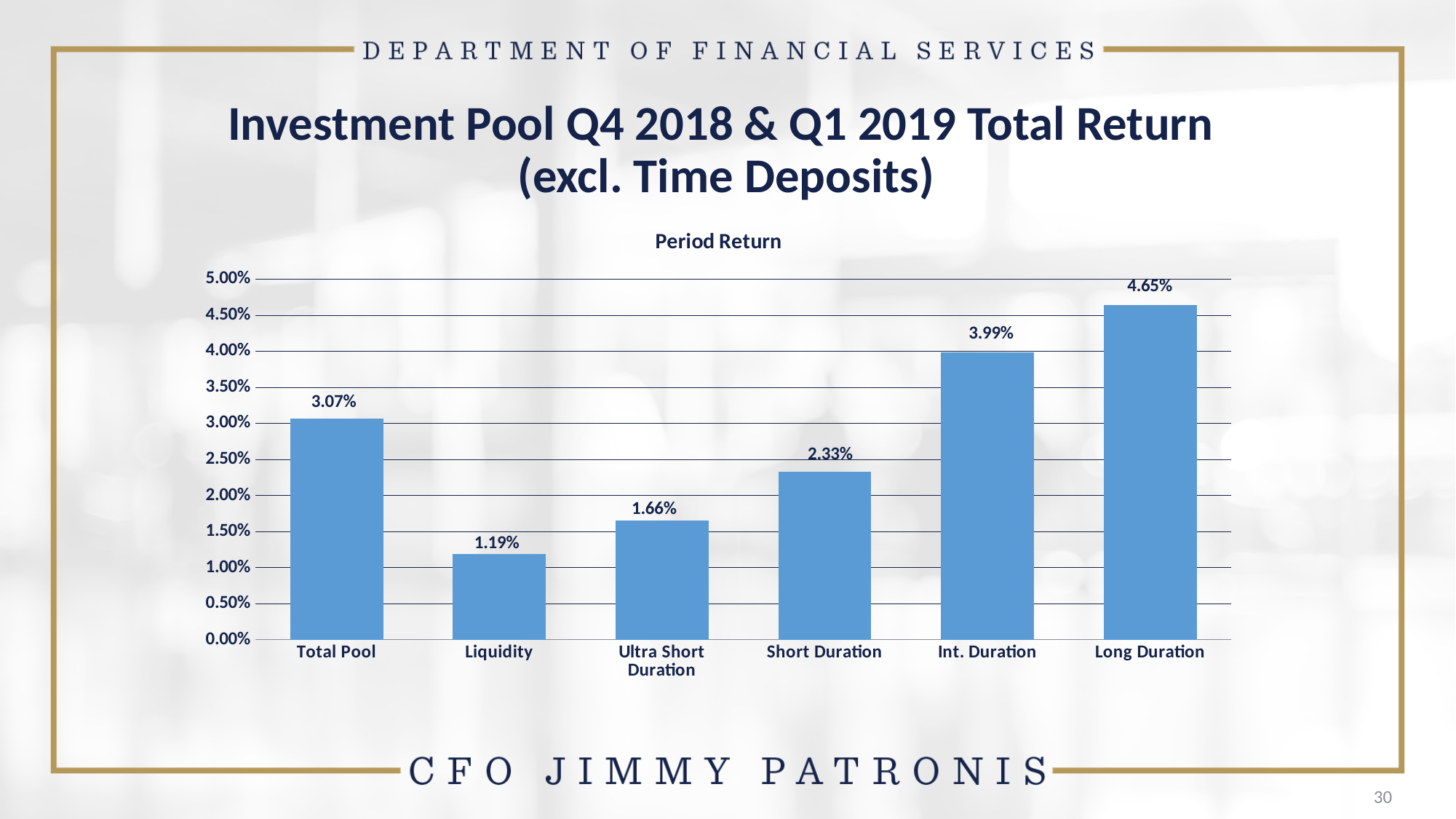
What is the period return for Liquidity? 1.19% How many categories are shown on the chart? 6 Which category has the lowest period return? Liquidity What is the title of the chart? Period Return Is the period return for Short Duration greater or less than 2.00%? greater Which category has the highest period return? Long Duration Which has a higher period return, Short Duration or Total Pool? Total Pool What is the period return for Int. Duration? 3.99% What is the period return for Total Pool? 3.07% What is the difference between the period return for Long Duration and Int. Duration? 0.66% What is the period return for Ultra Short Duration? 1.66% What kind of chart is shown on the slide? Bar chart